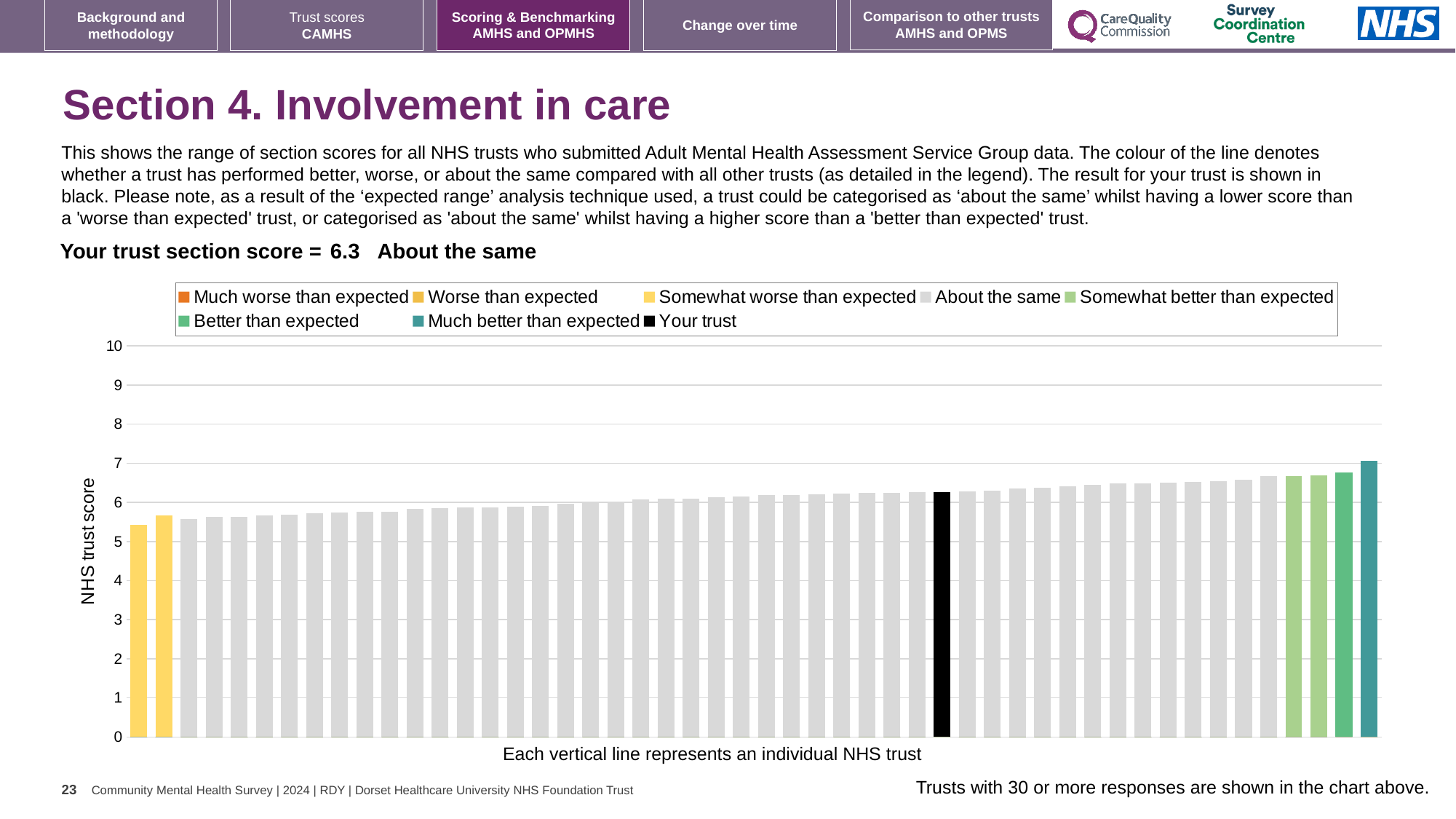
How many bars are coloured as 'Worse than expected'? 0 Which category is your trust placed in for this section? About the same What is the section score for your trust shown on the slide? 6.3 Which legend category does the tallest bar belong to? Much better than expected What colour is the bar representing your trust? Black Is the value of the leftmost (lowest) bar greater or less than 6? less Do the bar values rise or fall from left to right along the x axis? Rise Is the value for your trust greater or less than 5? greater How many entries does the chart legend list? 8 What kind of chart is shown on the slide? Bar chart Which legend category does the shortest bar belong to? Somewhat worse than expected How many bars are coloured as 'Much better than expected'? 1